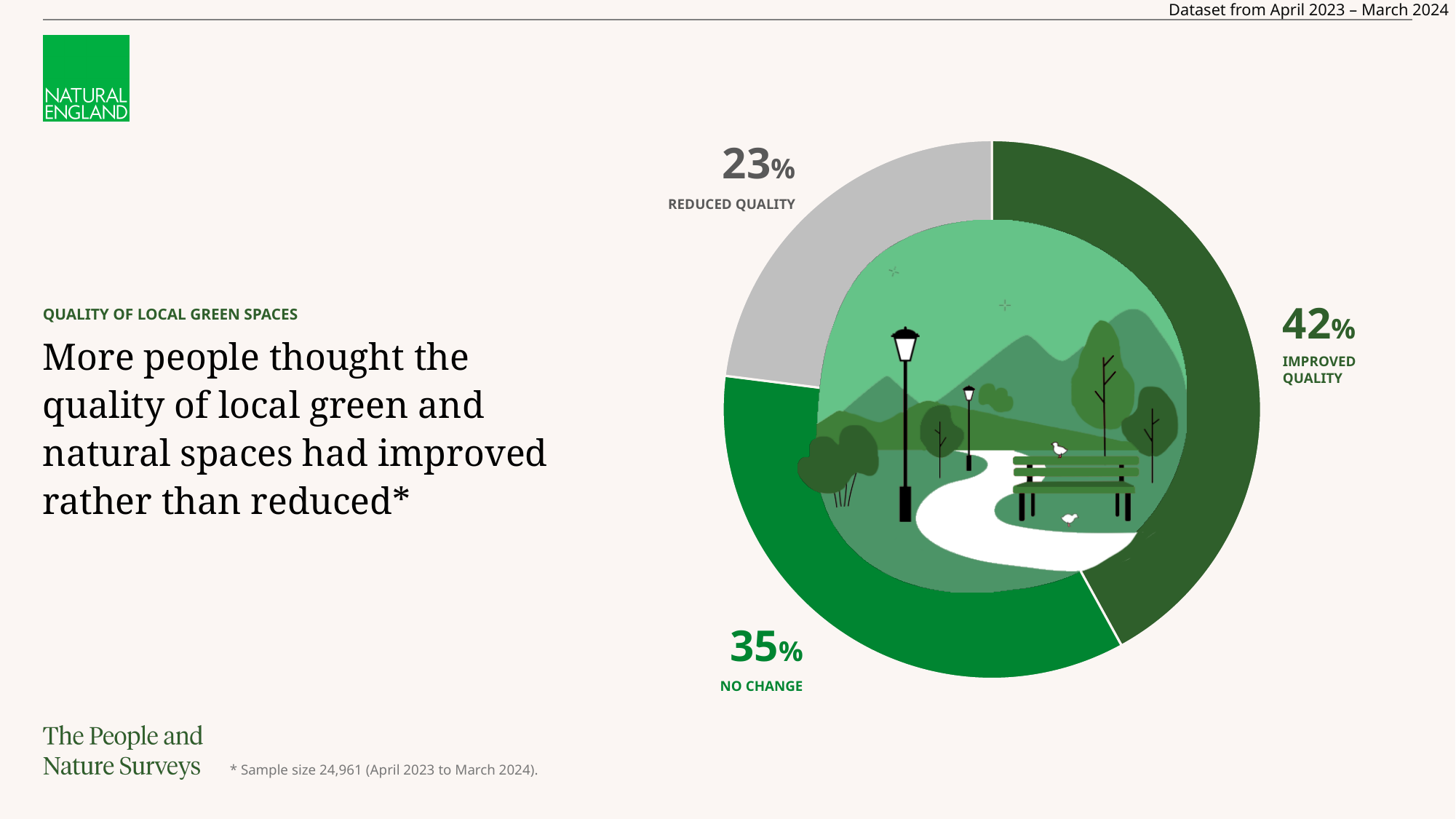
What percentage of people thought the quality of local green spaces had reduced? 23% What is the sample size stated in the footnote of the slide? 24,961 How many categories are shown in the chart? 3 What kind of chart is shown on the slide? Pie chart (donut) Which category has the smallest share of the chart? Reduced quality What colour is the 'Reduced quality' segment of the chart? Grey What percentage of people reported no change in the quality of local green spaces? 35% Which category has the largest share of the chart? Improved quality What percentage of people thought the quality of local green spaces had improved? 42% Which is larger: the share for 'No change' or the share for 'Reduced quality'? No change What is the difference in percentage points between 'Improved quality' and 'No change'? 7 What is the difference in percentage points between 'Improved quality' and 'Reduced quality'? 19